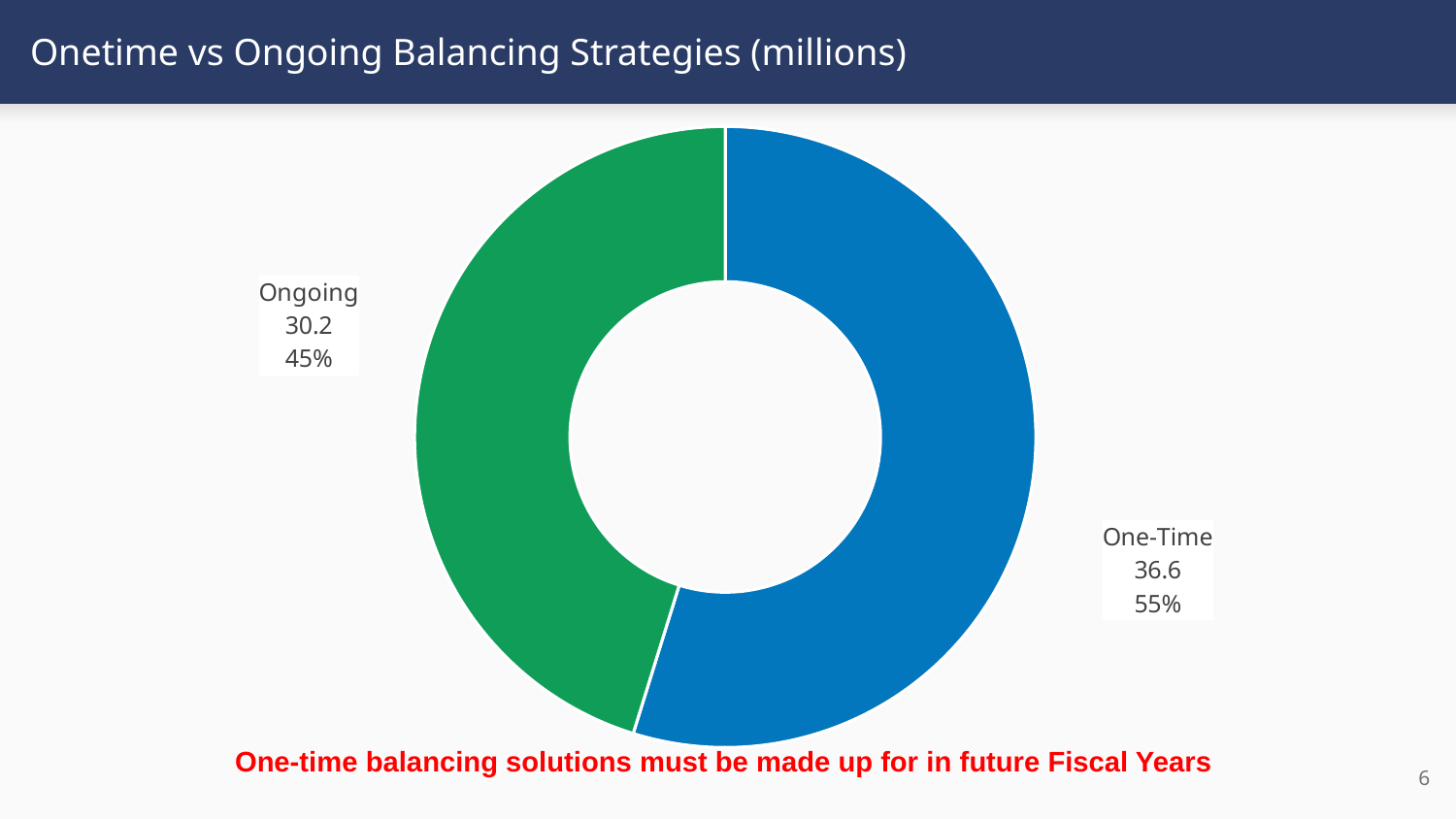
What is the difference between the One-Time and Ongoing values? 6.4 What kind of chart is shown on the slide? Doughnut (pie) chart Is the value for Ongoing larger or smaller than the value for One-Time? Smaller Which category has the smaller value? Ongoing How many categories are shown in the chart? 2 What is the value for One-Time? 36.6 What colour is the One-Time slice? Blue What is the title of the chart? Onetime vs Ongoing Balancing Strategies (millions) What share of the chart does the One-Time slice represent? 55% What share of the chart does the Ongoing slice represent? 45% Which category has the larger value? One-Time What is the value for Ongoing? 30.2